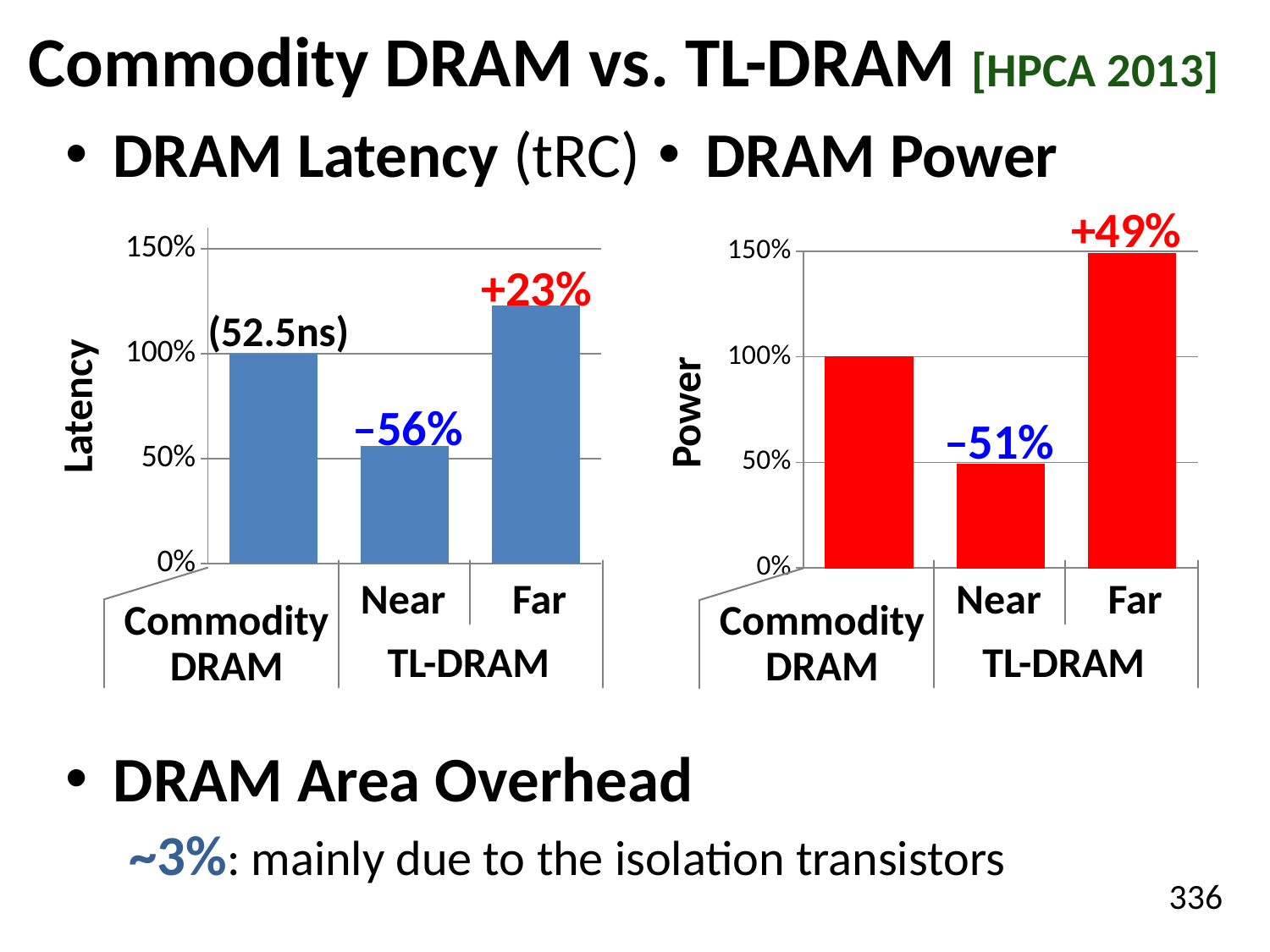
In the DRAM Latency chart, what annotation is printed above the Far bar for TL-DRAM? +23% In the DRAM Power chart, what annotation is printed above the Near bar for TL-DRAM? –51% In the DRAM Latency chart, is the value for the Near bar greater or less than 100%? less What type of chart is the DRAM Latency chart? Bar chart In the DRAM Power chart, what annotation is printed above the Far bar for TL-DRAM? +49% In the DRAM Power chart, is the value for the Far bar greater or less than 100%? greater In the DRAM Latency chart, what absolute latency is printed next to the Commodity DRAM bar? (52.5ns) In the DRAM Latency chart, which is larger, the Commodity DRAM bar or the Far bar? Far How many bars are plotted in the DRAM Power chart? 3 In the DRAM Latency chart, what annotation is printed above the Near bar for TL-DRAM? –56% In the DRAM Power chart, which bar is the highest? Far (TL-DRAM) In the DRAM Latency chart, which bar is the lowest? Near (TL-DRAM)